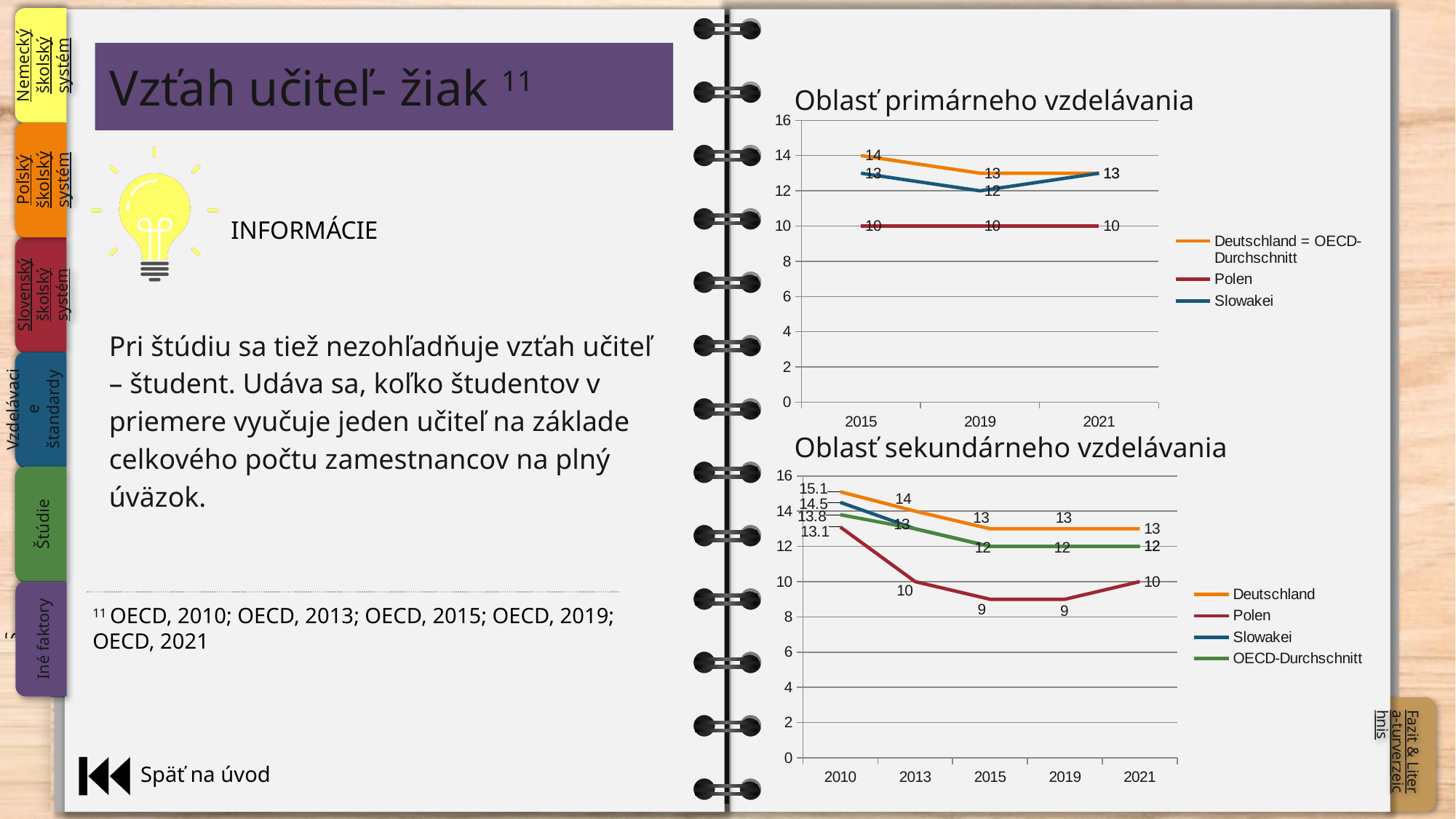
In the 'Oblasť sekundárneho vzdelávania' chart, what is the difference between Deutschland and Polen in 2021? 3 In the 'Oblasť sekundárneho vzdelávania' chart, does the value for Deutschland rise or fall from 2010 to 2015? fall In the 'Oblasť primárneho vzdelávania' chart, what is the value for Slowakei in 2019? 12 In the 'Oblasť sekundárneho vzdelávania' chart, what is the value for Polen in 2015? 9 In the 'Oblasť primárneho vzdelávania' chart, what is the value for Deutschland = OECD-Durchschnitt in 2015? 14 How many years are shown on the x axis of the 'Oblasť sekundárneho vzdelávania' chart? 5 How many series does the legend of the 'Oblasť sekundárneho vzdelávania' chart list? 4 How many series does the legend of the 'Oblasť primárneho vzdelávania' chart list? 3 In the 'Oblasť sekundárneho vzdelávania' chart, what is the value for Deutschland in 2010? 15.1 In the 'Oblasť primárneho vzdelávania' chart, what is the value for Polen in 2019? 10 What type of chart is 'Oblasť primárneho vzdelávania'? line chart In the 'Oblasť primárneho vzdelávania' chart, which series has the lowest value in 2021? Polen